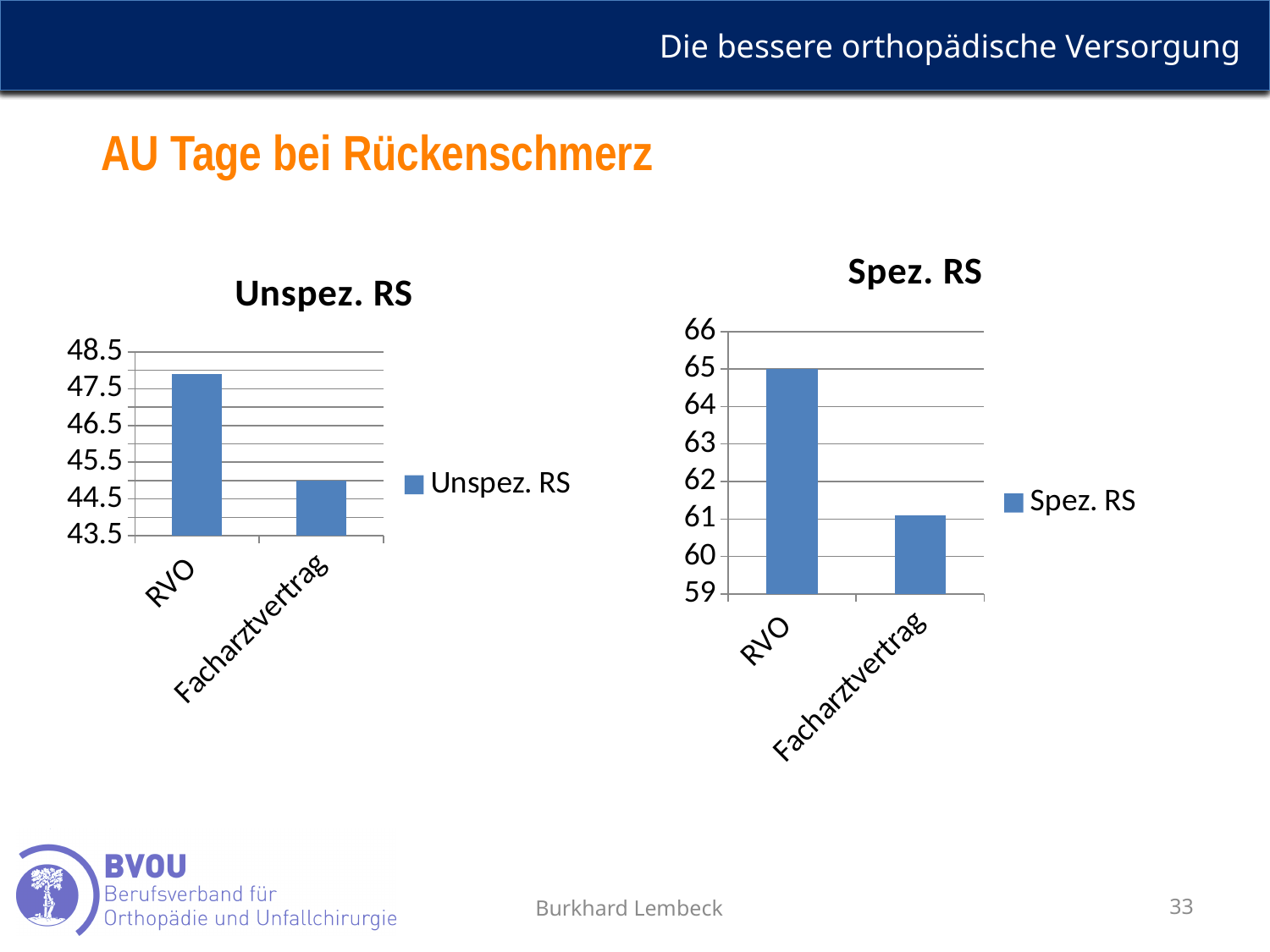
What kind of chart is the Unspez. RS chart? bar chart In the Spez. RS chart, is the value for RVO larger or smaller than the value for Facharztvertrag? larger What is the title of the chart on the right side of the slide? Spez. RS In the Unspez. RS chart, is the value for RVO greater or less than 47.5? greater In the Unspez. RS chart, how many categories are shown on the x axis? 2 In the Unspez. RS chart, is the value for Facharztvertrag greater or less than 45.5? less In the Unspez. RS chart, which category has the higher value? RVO In the Spez. RS chart, what is the value for RVO? 65 In the Spez. RS chart, is the value for Facharztvertrag greater or less than 62? less In the Unspez. RS chart, which category has the lowest value? Facharztvertrag In the Spez. RS chart, which category has the higher value? RVO How many series does the legend of the Spez. RS chart list? 1